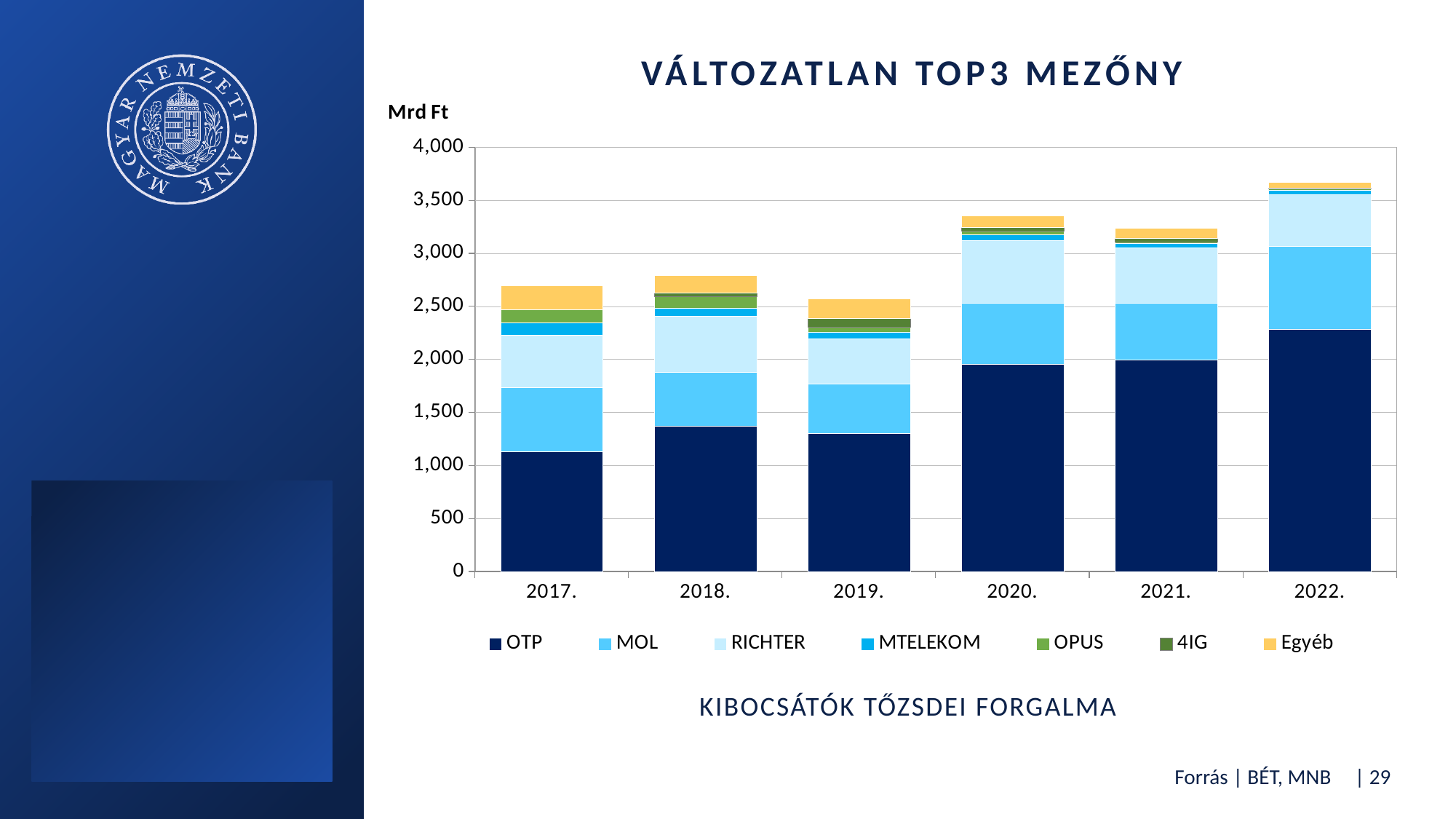
What kind of chart is shown on the slide? Stacked bar chart What unit is shown above the vertical axis? Mrd Ft Is the total bar for 2022. greater or less than 3,500? greater How many series does the legend list? 7 Is the total bar for 2019. greater or less than 3,000? less Is the OTP segment for 2022. greater or less than 2,000? greater Which year has the lowest total stacked bar? 2019. Which year has the larger total bar, 2020. or 2021.? 2020. Which series forms the bottom segment of each stacked bar? OTP Which year has the highest total stacked bar? 2022. How many years (categories) are shown on the x axis? 6